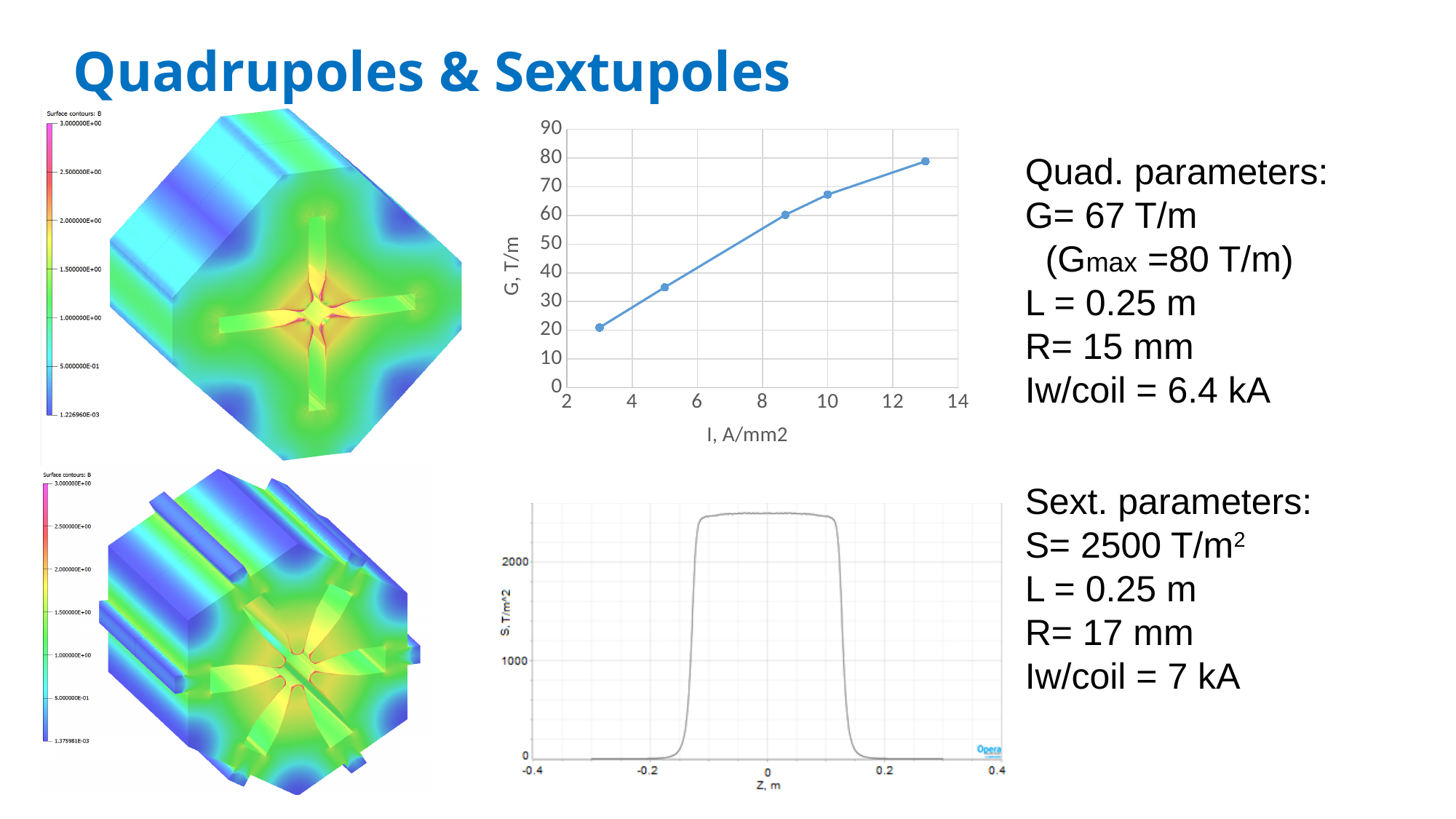
In the top chart of G versus I, how many data points are plotted? 5 In the top chart of G versus I, is the value of G at I = 5 A/mm2 greater or less than 40? less What is the y-axis label of the top chart of G versus I? G, T/m In the top chart of G versus I, is the value of G at I = 13 A/mm2 greater or less than 70? greater What kind of chart is the top chart of G versus I? line chart What kind of chart is the bottom chart of S versus Z? line chart In the top chart of G versus I, does G rise or fall as I increases? rise In the top chart of G versus I, which plotted point has the highest G value, the one at I = 3 or the one at I = 13 A/mm2? I = 13 A/mm2 What is the x-axis label of the top chart of G versus I? I, A/mm2 In the bottom chart of S versus Z, is the value of S at Z = 0 m greater or less than 2000? greater